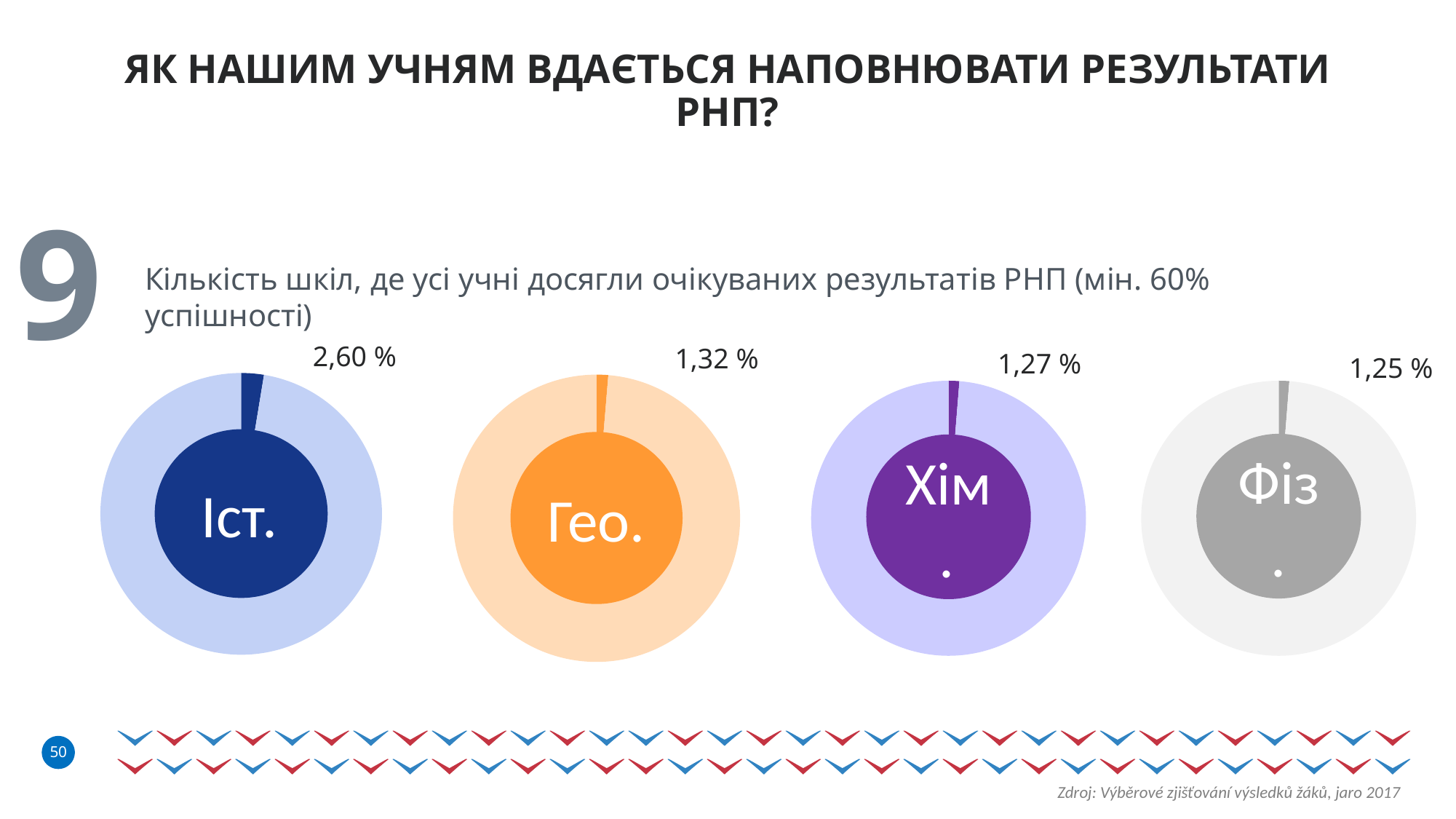
What value is shown for the Іст. chart? 2,60 % Which is larger, the value for Хім. or the value for Фіз.? Хім. What colour is the Гео. chart? Orange What value is shown for the Хім. chart? 1,27 % How many charts are shown on the slide? 4 What value is shown for the Фіз. chart? 1,25 % What is the difference between the values for Іст. and Гео.? 1,28 % Which subject has the lowest value among the four charts? Фіз. What is the difference between the values for Гео. and Хім.? 0,05 % Which subject has the highest value among the four charts? Іст. What kind of chart is used to show each subject's value? Donut (pie) chart What value is shown for the Гео. chart? 1,32 %